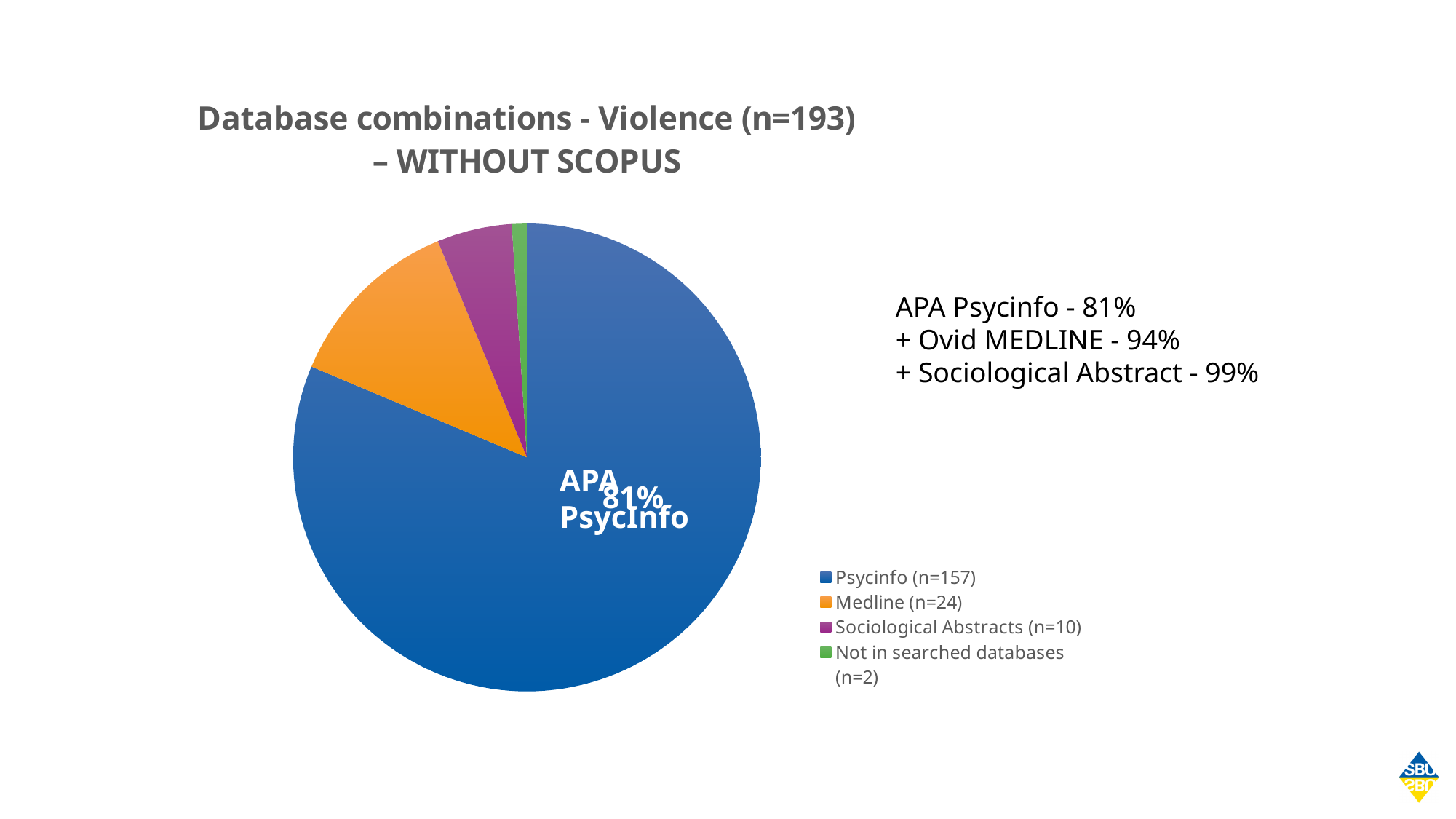
What n value does the legend give for Sociological Abstracts? 10 What is the title of the chart? Database combinations - Violence (n=193) – WITHOUT SCOPUS Which category has the smallest slice of the pie? Not in searched databases (n=2) What colour is the Medline slice? orange What kind of chart is shown on the slide? pie chart What is the difference between the n values for Psycinfo and Medline shown in the legend? 133 What n value does the legend give for Not in searched databases? 2 Which category has the largest slice of the pie? Psycinfo (n=157) What n value does the legend give for Medline? 24 What percentage share is printed on the Psycinfo slice? 81% How many slices does the pie chart have? 4 Which is larger, the Medline slice or the Sociological Abstracts slice? Medline